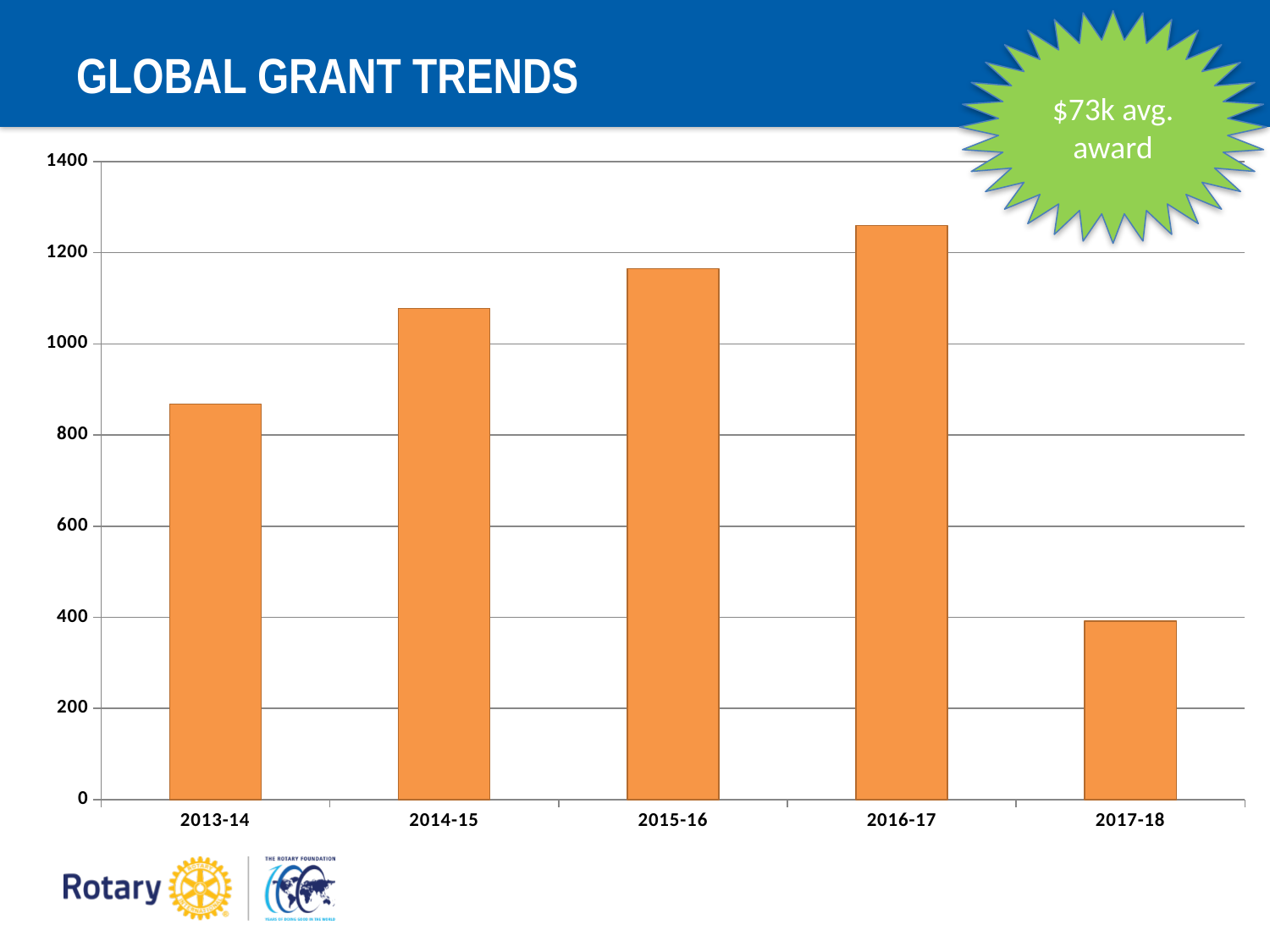
Which year has the lowest bar? 2017-18 Do the values rise or fall from 2013-14 to 2016-17? rise How many categories (years) are shown on the x axis? 5 What is the title of the slide containing the chart? GLOBAL GRANT TRENDS Is the value for 2017-18 greater or less than 600? less What kind of chart is shown on the slide? bar chart Is the value for 2016-17 greater or less than 1200? greater Which year has the highest bar? 2016-17 Which is larger, the value for 2015-16 or the value for 2014-15? 2015-16 Is the value for 2013-14 greater or less than 800? greater